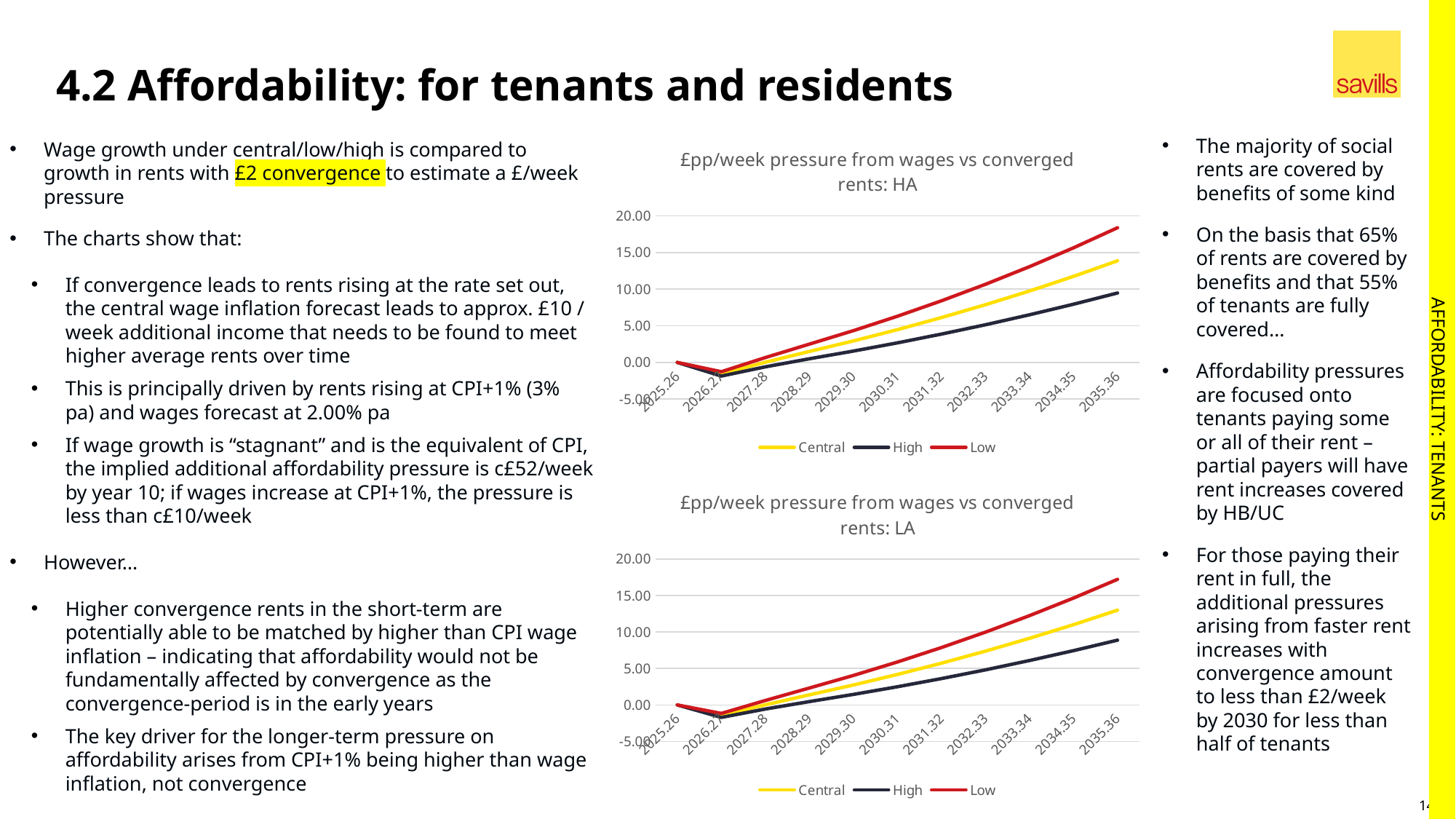
In the '£pp/week pressure from wages vs converged rents: HA' chart, which series is highest at 2035.36? Low In the '£pp/week pressure from wages vs converged rents: HA' chart, which is larger at 2035.36, the Central value or the High value? Central In the '£pp/week pressure from wages vs converged rents: LA' chart, is the Central value at 2035.36 greater or less than 10.00? greater What colour is the Low series line in the '£pp/week pressure from wages vs converged rents: HA' chart? red In the '£pp/week pressure from wages vs converged rents: HA' chart, is the Low value at 2035.36 greater or less than 15.00? greater What kind of chart is the '£pp/week pressure from wages vs converged rents: HA' chart? line chart How many years are plotted along the x axis of the '£pp/week pressure from wages vs converged rents: HA' chart? 11 In the '£pp/week pressure from wages vs converged rents: LA' chart, do the Central values rise or fall from 2027.28 to 2035.36? rise In the '£pp/week pressure from wages vs converged rents: LA' chart, which series is lowest at 2035.36? High In the '£pp/week pressure from wages vs converged rents: LA' chart, is the High value at 2035.36 greater or less than 10.00? less How many series does the legend of the '£pp/week pressure from wages vs converged rents: LA' chart list? 3